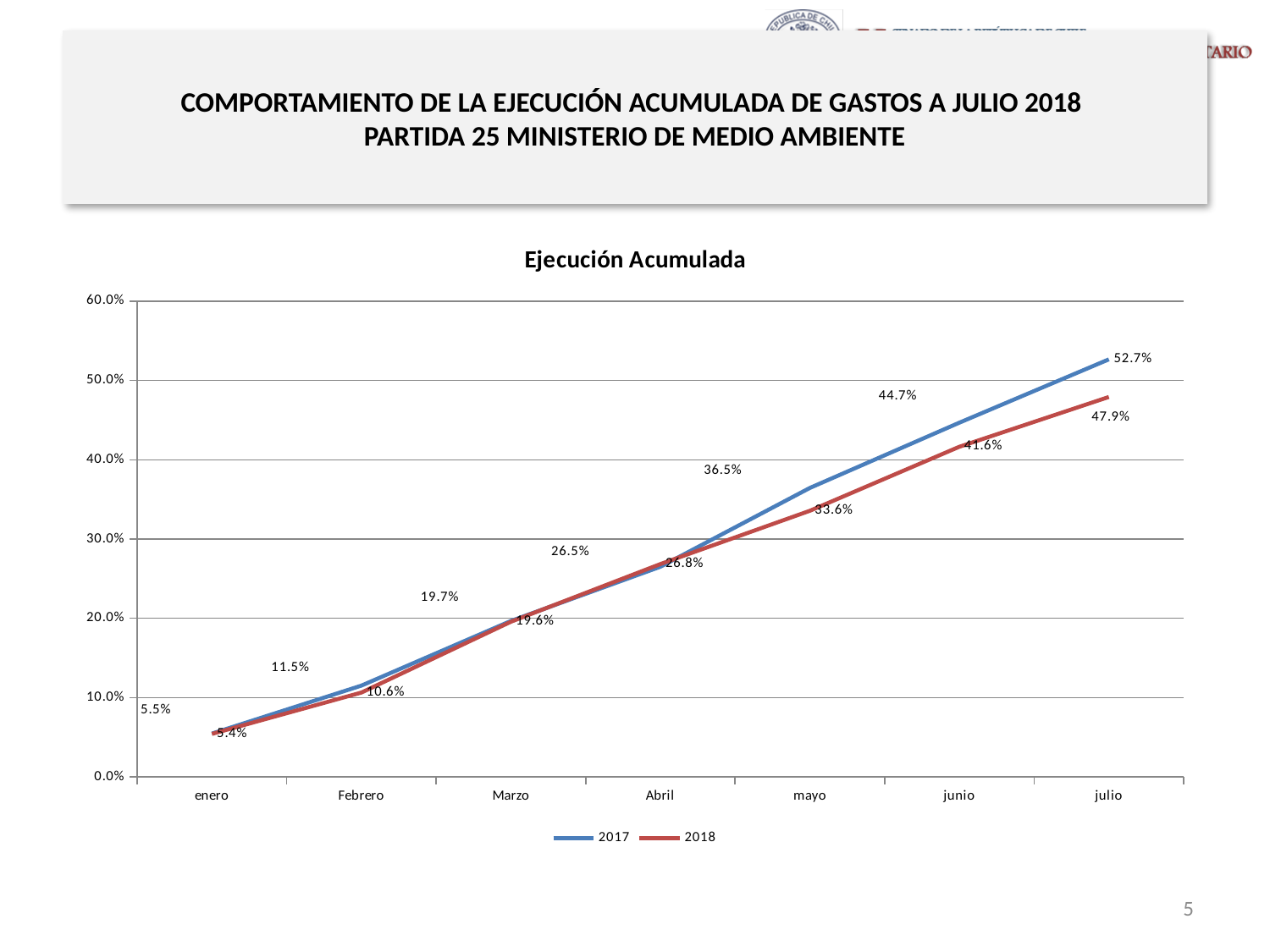
Do the values for 2017 rise or fall from enero to julio? rise How many series does the legend list? 2 What is the value for 2018 in julio? 47.9% What is the value for 2017 in julio? 52.7% What is the title of the chart? Ejecución Acumulada How many months are shown on the x axis? 7 What is the value for 2018 in mayo? 33.6% What is the difference between the 2017 and 2018 values in julio? 4.8% What type of chart is shown on the slide? line chart In which month is the 2018 value lowest? enero What is the value for 2017 in Febrero? 11.5% Which series has the higher value in junio, 2017 or 2018? 2017